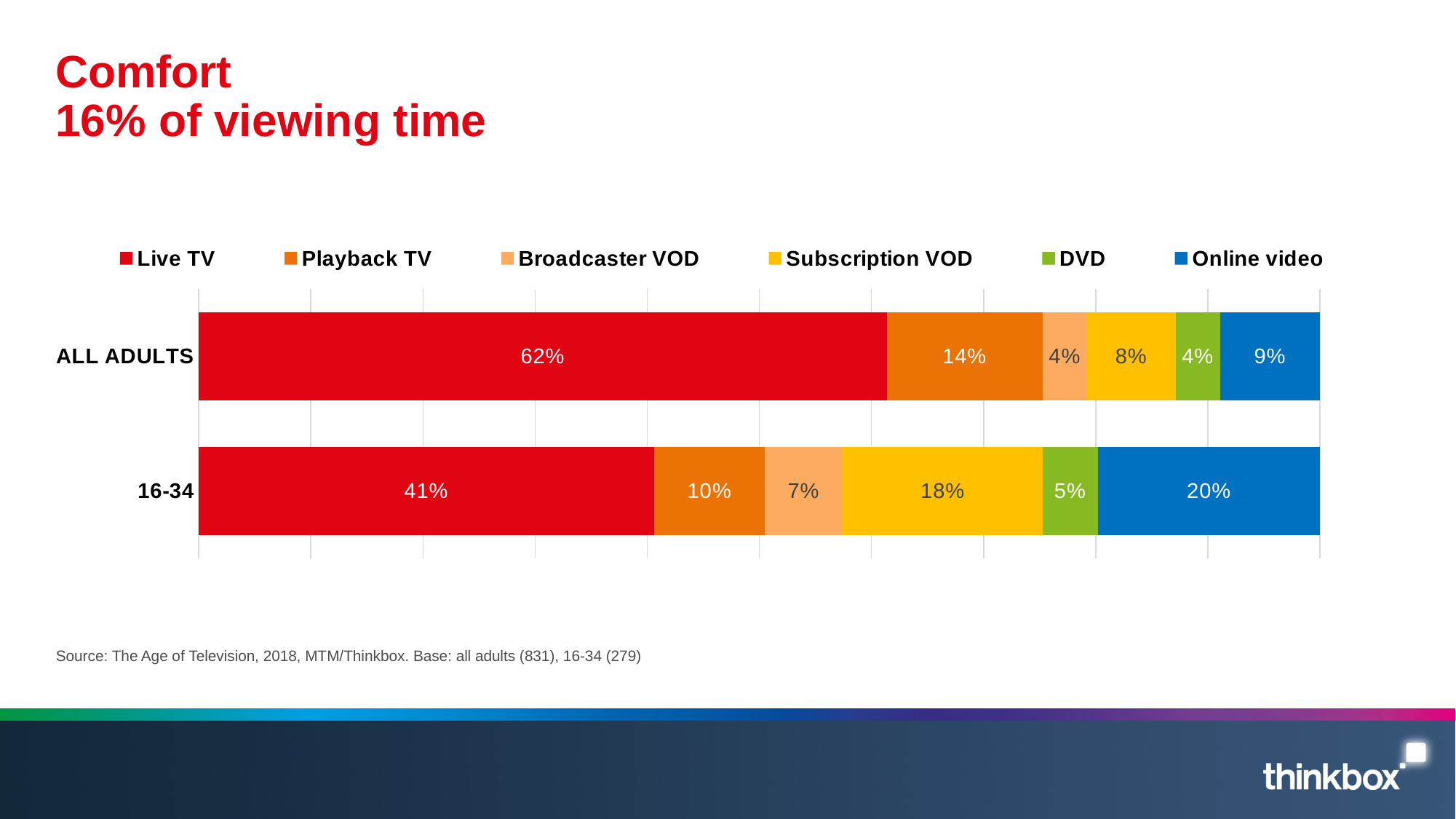
What share of viewing time is Online video for the 16-34 group? 20% What colour represents Subscription VOD in the chart? Yellow What share of viewing time is Subscription VOD for the 16-34 group? 18% How many series does the legend list? 6 Which series has the largest share for the 16-34 group? Live TV What kind of chart is shown on the slide? Stacked bar chart Which series has the smallest share for the 16-34 group? DVD What share of viewing time is Playback TV for All Adults? 14% What share of viewing time is Live TV for All Adults? 62% How many groups (bars) are shown on the chart? 2 Which group has the larger Online video share, All Adults or 16-34? 16-34 What is the difference between the Live TV share for All Adults and for 16-34? 21%